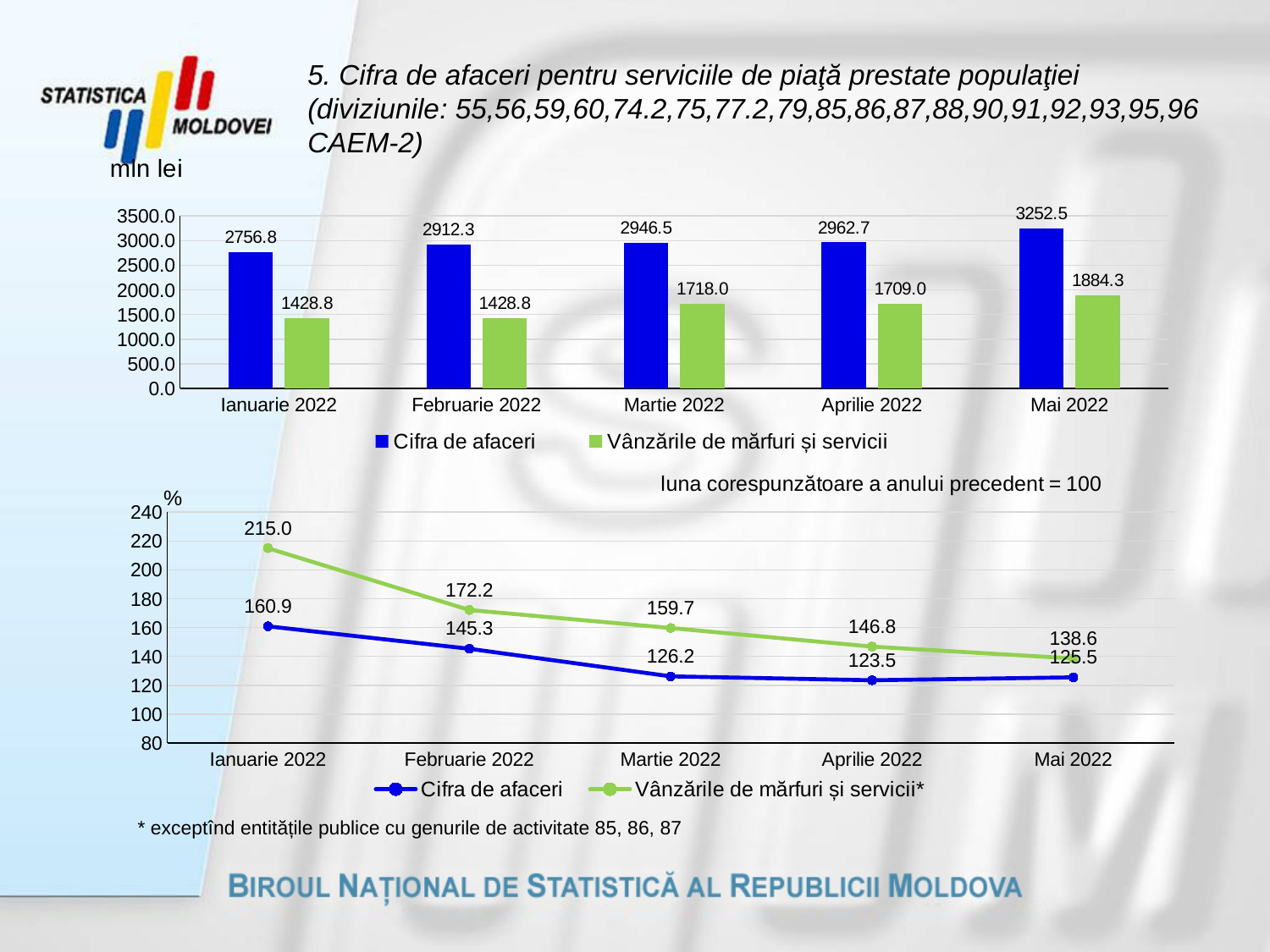
What kind of chart is the top chart on the slide? bar chart In the top bar chart, is the value of Vânzările de mărfuri și servicii for Aprilie 2022 greater or less than 1500.0? greater In the top bar chart, which month has the highest value for Cifra de afaceri? Mai 2022 In the bottom line chart, what is the value of Vânzările de mărfuri și servicii* for Ianuarie 2022? 215.0 How many series does the legend of the bottom line chart list? 2 In the bottom line chart, what is the value of Cifra de afaceri for Aprilie 2022? 123.5 In the top bar chart, what is the value of Vânzările de mărfuri și servicii for Martie 2022? 1718.0 In the bottom line chart, does the Vânzările de mărfuri și servicii* line rise or fall from Ianuarie 2022 to Mai 2022? fall In the top bar chart, what is the difference between Cifra de afaceri and Vânzările de mărfuri și servicii in Ianuarie 2022? 1328.0 In the bottom line chart, which series has the larger value in Martie 2022, Cifra de afaceri or Vânzările de mărfuri și servicii*? Vânzările de mărfuri și servicii* In the top bar chart, which month has the lowest value for Cifra de afaceri? Ianuarie 2022 In the top bar chart, what is the value of Cifra de afaceri for Mai 2022? 3252.5